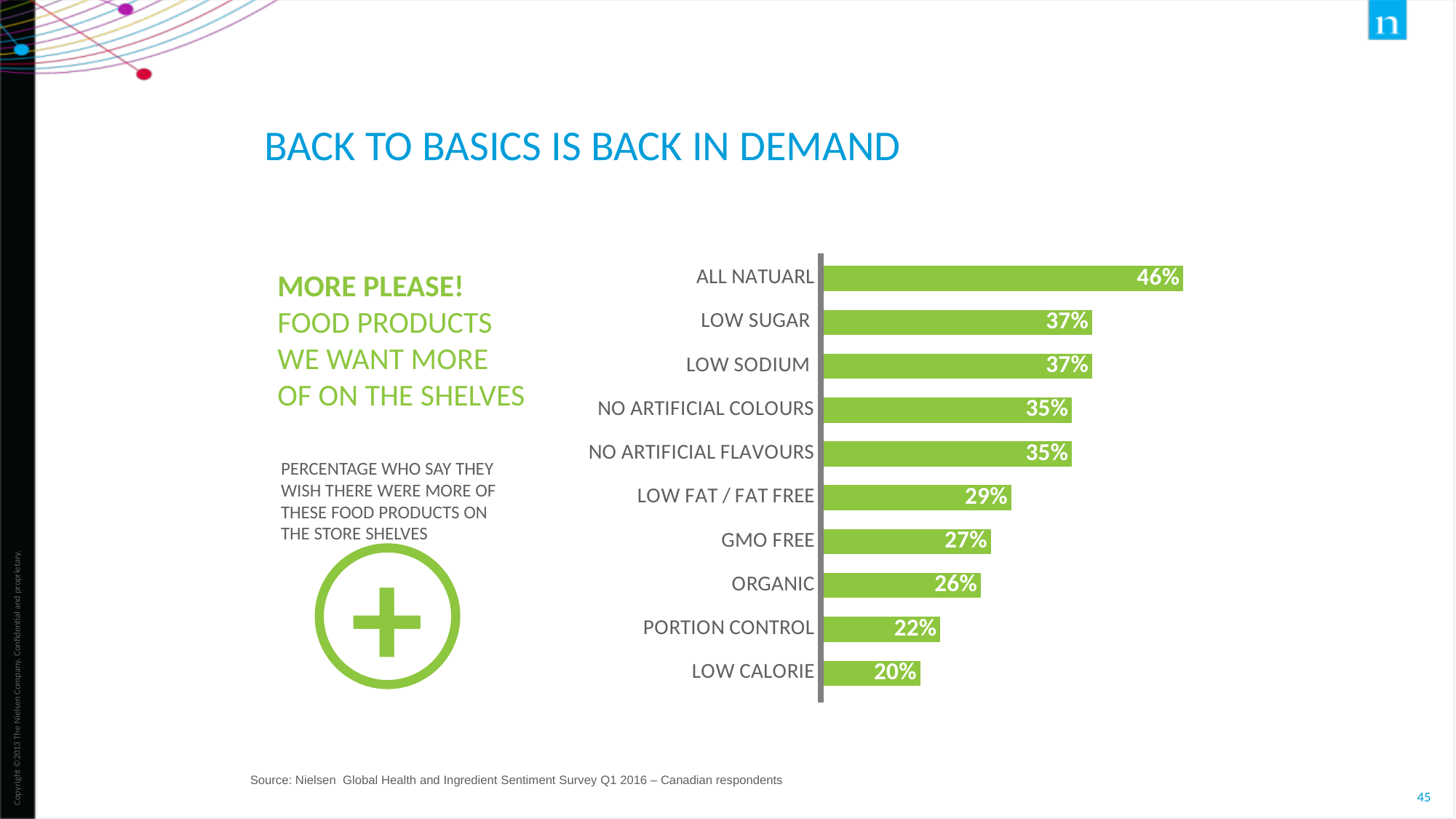
What is the value shown for LOW FAT / FAT FREE? 29% What percentage of respondents wish there were more ALL NATUARL food products on the shelves? 46% What colour are the bars in the chart? Green How many categories are shown in the chart? 10 Which category has the lowest value? LOW CALORIE What is the difference between the values for ALL NATUARL and LOW CALORIE? 26% Which category has the highest value? ALL NATUARL Which has a larger value, GMO FREE or ORGANIC? GMO FREE What is the value shown for GMO FREE? 27% What kind of chart is shown on the slide? Bar chart What is the difference between the values for LOW SUGAR and ORGANIC? 11% What is the value shown for PORTION CONTROL? 22%